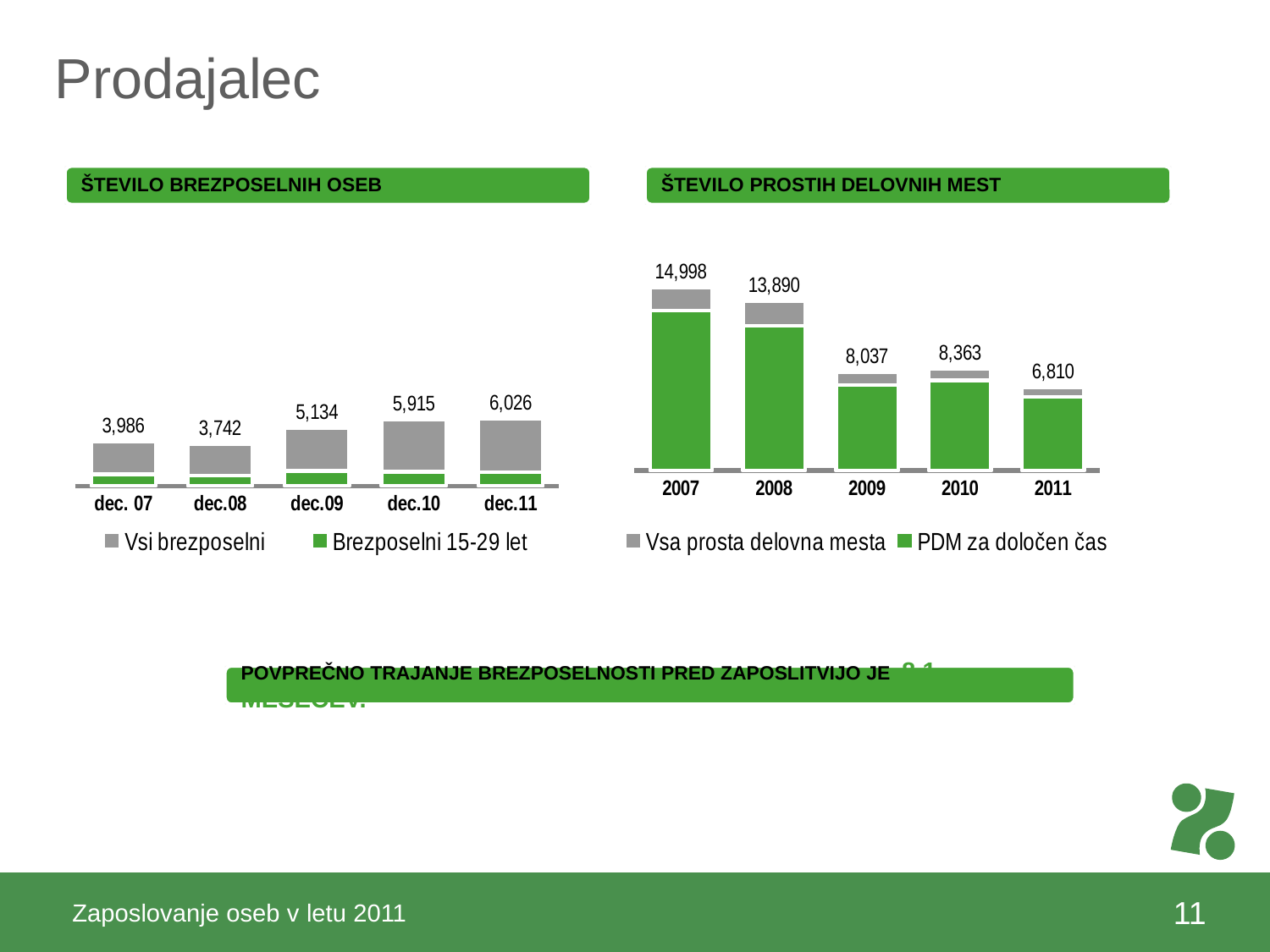
In the chart titled ŠTEVILO BREZPOSELNIH OSEB, what is the difference between the labelled values for dec.11 and dec. 07? 2,040 In the chart titled ŠTEVILO BREZPOSELNIH OSEB, which category has the lowest labelled value? dec.08 In the chart titled ŠTEVILO PROSTIH DELOVNIH MEST, what is the labelled value for 2007? 14,998 What kind of chart is the chart titled ŠTEVILO PROSTIH DELOVNIH MEST? bar chart In the chart titled ŠTEVILO PROSTIH DELOVNIH MEST, which year has the lowest labelled value? 2011 In the chart titled ŠTEVILO BREZPOSELNIH OSEB, what is the labelled value for dec.11? 6,026 In the chart titled ŠTEVILO BREZPOSELNIH OSEB, what is the labelled value for dec.08? 3,742 In the chart titled ŠTEVILO BREZPOSELNIH OSEB, which category has the highest labelled value? dec.11 In the chart titled ŠTEVILO BREZPOSELNIH OSEB, how many series does the legend list? 2 In the chart titled ŠTEVILO PROSTIH DELOVNIH MEST, what is the labelled value for 2010? 8,363 In the chart titled ŠTEVILO PROSTIH DELOVNIH MEST, what is the difference between the labelled values for 2007 and 2011? 8,188 In the chart titled ŠTEVILO PROSTIH DELOVNIH MEST, how many years are shown on the x axis? 5